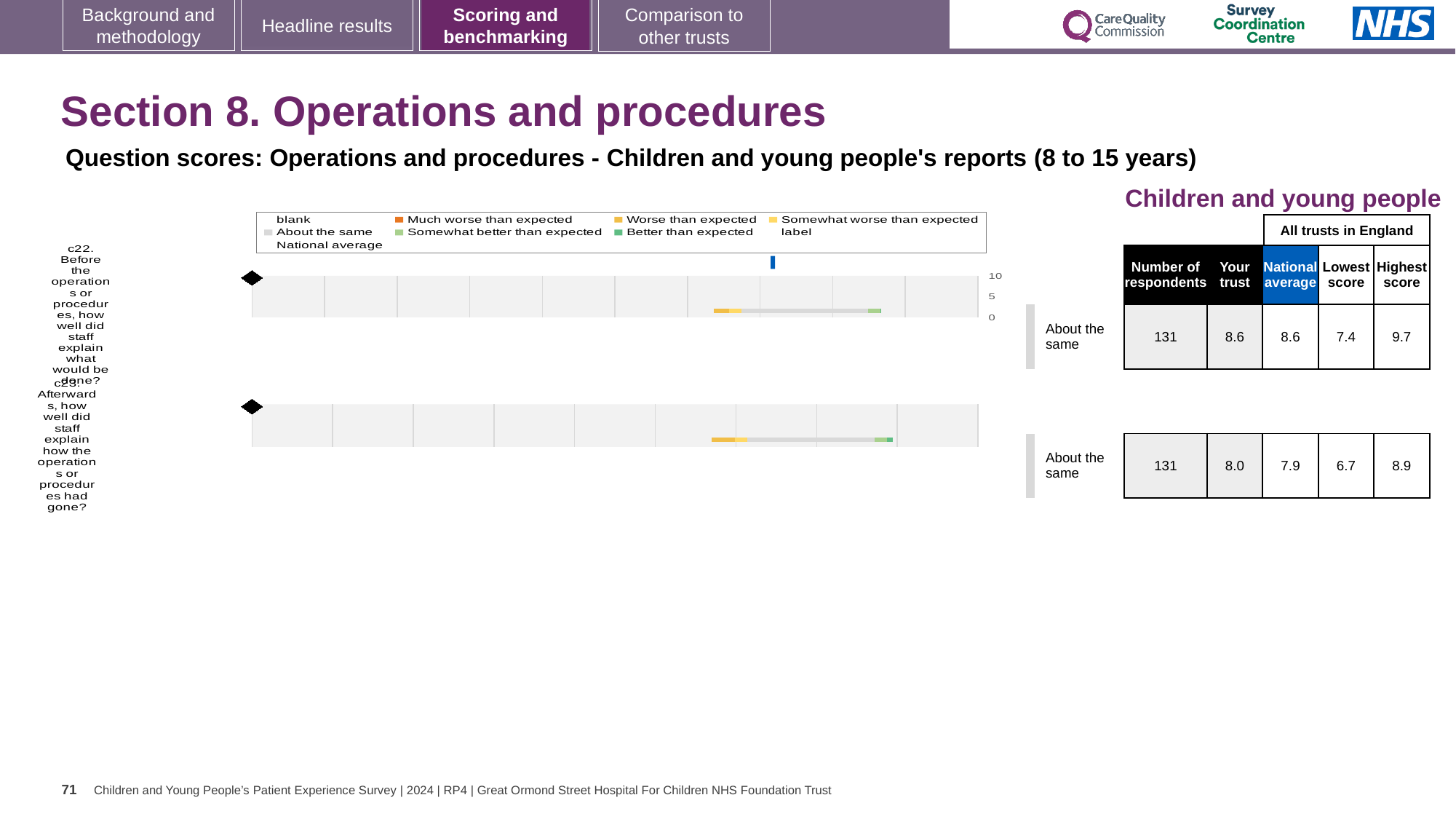
Which legend entry is shown in orange? Much worse than expected What is the lowest score across all trusts in England for c23? 6.7 What is the national average score for c23 (Afterwards, how well did staff explain how the operations or procedures had gone?)? 7.9 How many respondents answered question c22? 131 What is the 'Your trust' score for c22 (Before the operations or procedures, how well did staff explain what would be done?)? 8.6 For c23, which is larger: the 'Your trust' score or the national average? Your trust How many questions (bars) are plotted in the chart? 2 How many entries does the chart legend list? 9 What is the highest tick value shown on the chart's score axis? 10 What is the difference between the highest score and the lowest score for c22? 2.3 What benchmark category is given for both c22 and c23? About the same What kind of chart is used to show the question scores for c22 and c23? bar chart